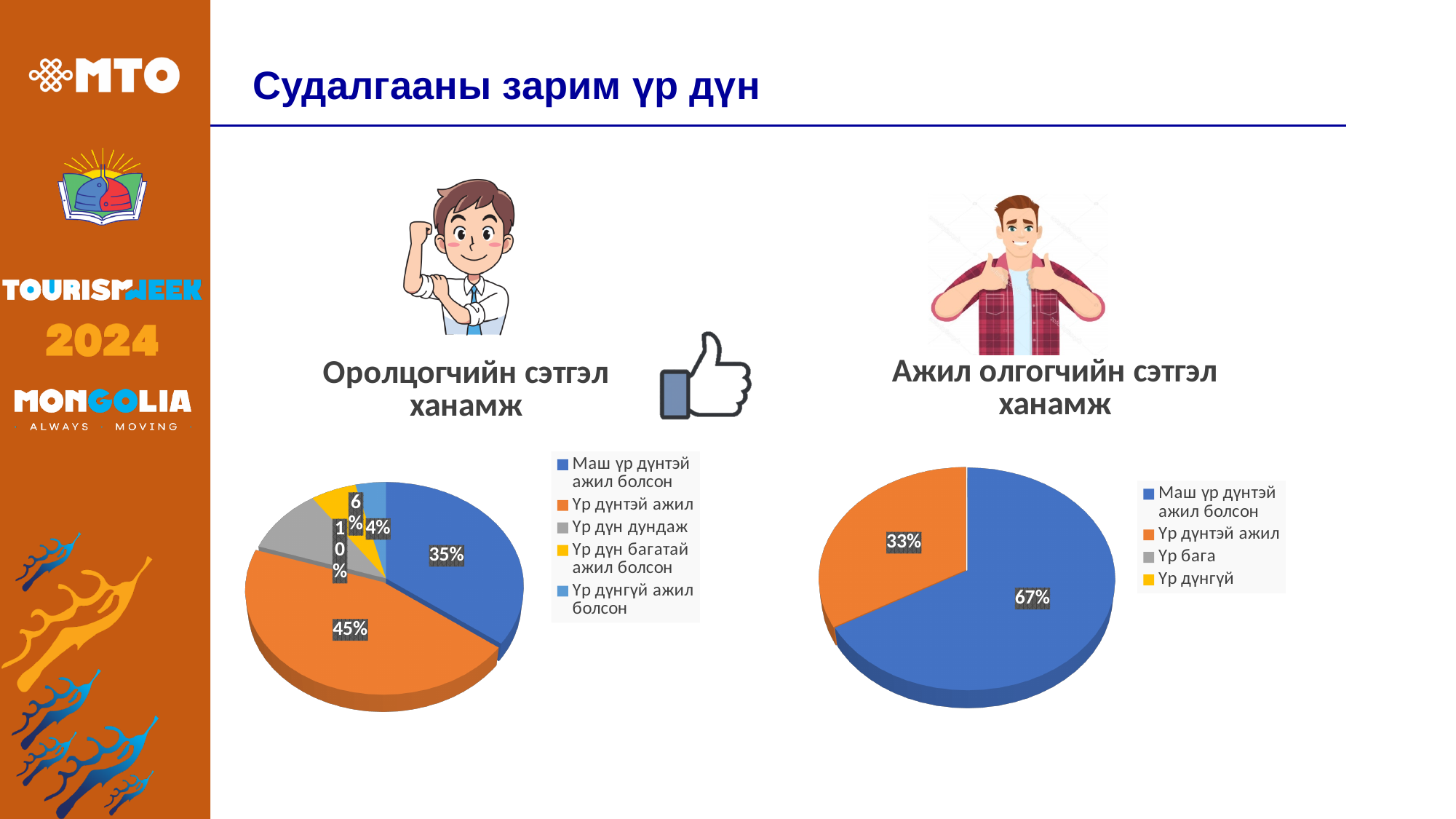
How many entries does the legend of the "Оролцогчийн сэтгэл ханамж" chart list? 5 In the "Ажил олгогчийн сэтгэл ханамж" chart, what share is labelled for "Үр дүнтэй ажил"? 33% In the "Ажил олгогчийн сэтгэл ханамж" chart, which is larger: "Маш үр дүнтэй ажил болсон" or "Үр дүнтэй ажил"? Маш үр дүнтэй ажил болсон In the "Ажил олгогчийн сэтгэл ханамж" chart, what colour is the "Үр дүнтэй ажил" slice? Orange In the "Оролцогчийн сэтгэл ханамж" chart, which category has the smallest slice? Үр дүнгүй ажил болсон In the "Ажил олгогчийн сэтгэл ханамж" chart, what share is labelled for "Маш үр дүнтэй ажил болсон"? 67% In the "Оролцогчийн сэтгэл ханамж" chart, which category has the largest slice? Үр дүнтэй ажил In the "Оролцогчийн сэтгэл ханамж" chart, what share is labelled for "Маш үр дүнтэй ажил болсон"? 35% In the "Оролцогчийн сэтгэл ханамж" chart, what share is labelled for "Үр дүнтэй ажил"? 45% In the "Оролцогчийн сэтгэл ханамж" chart, what share is labelled for "Үр дүн дундаж"? 10% What type of chart is used for "Оролцогчийн сэтгэл ханамж"? Pie chart In the "Оролцогчийн сэтгэл ханамж" chart, what is the difference between the "Үр дүнтэй ажил" and "Маш үр дүнтэй ажил болсон" shares? 10%